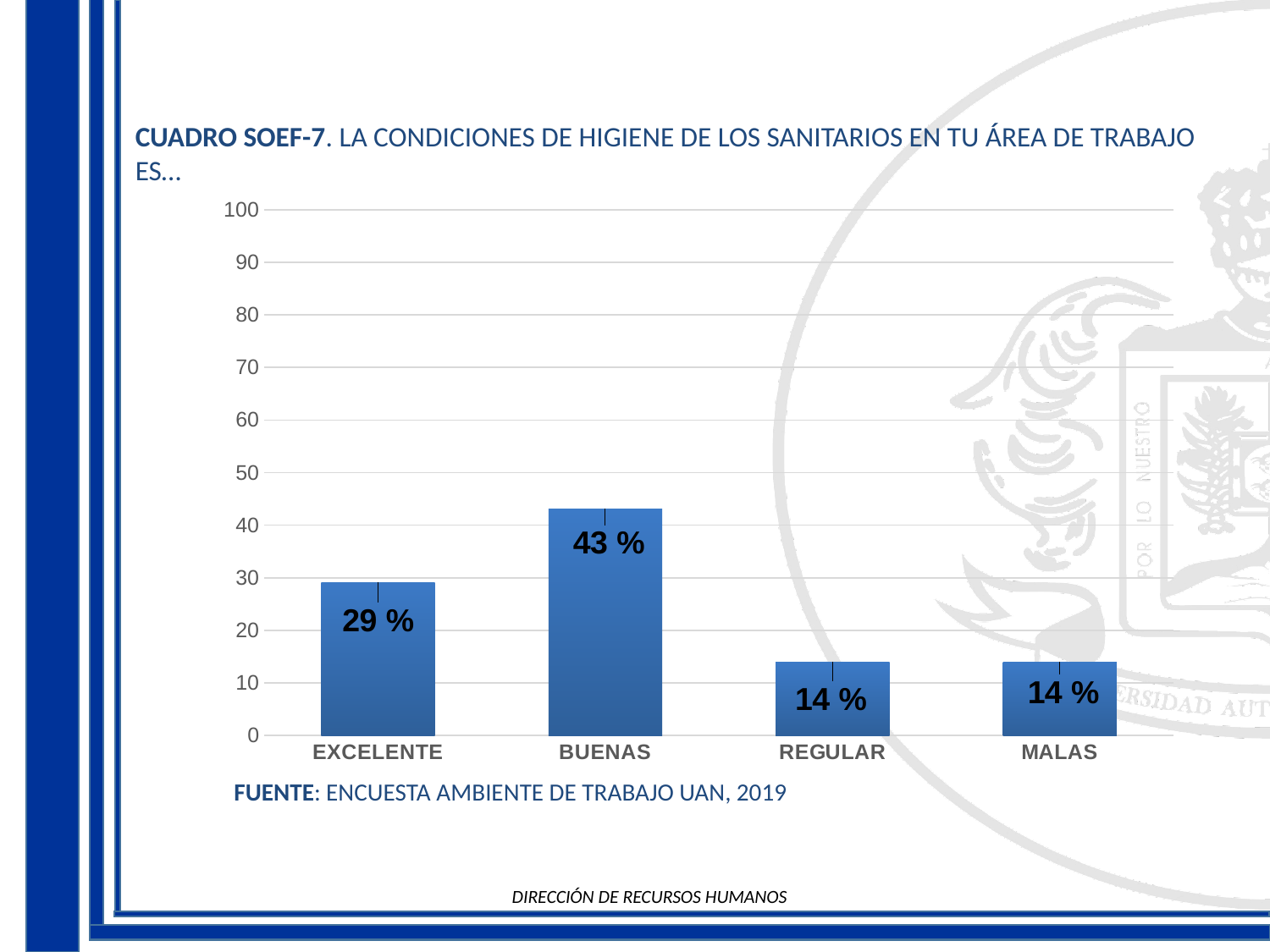
Which is larger, the value for EXCELENTE or the value for MALAS? EXCELENTE What kind of chart is shown on the slide? bar chart What is the difference between the values for EXCELENTE and REGULAR? 15 % What is the value for REGULAR? 14 % What is the value for EXCELENTE? 29 % Is the value for BUENAS greater or less than 40? greater What is the difference between the values for BUENAS and EXCELENTE? 14 % What source is cited below the chart? ENCUESTA AMBIENTE DE TRABAJO UAN, 2019 What is the value for BUENAS? 43 % Which category has the highest value? BUENAS How many categories are shown on the x axis? 4 Is the value for MALAS greater or less than 20? less